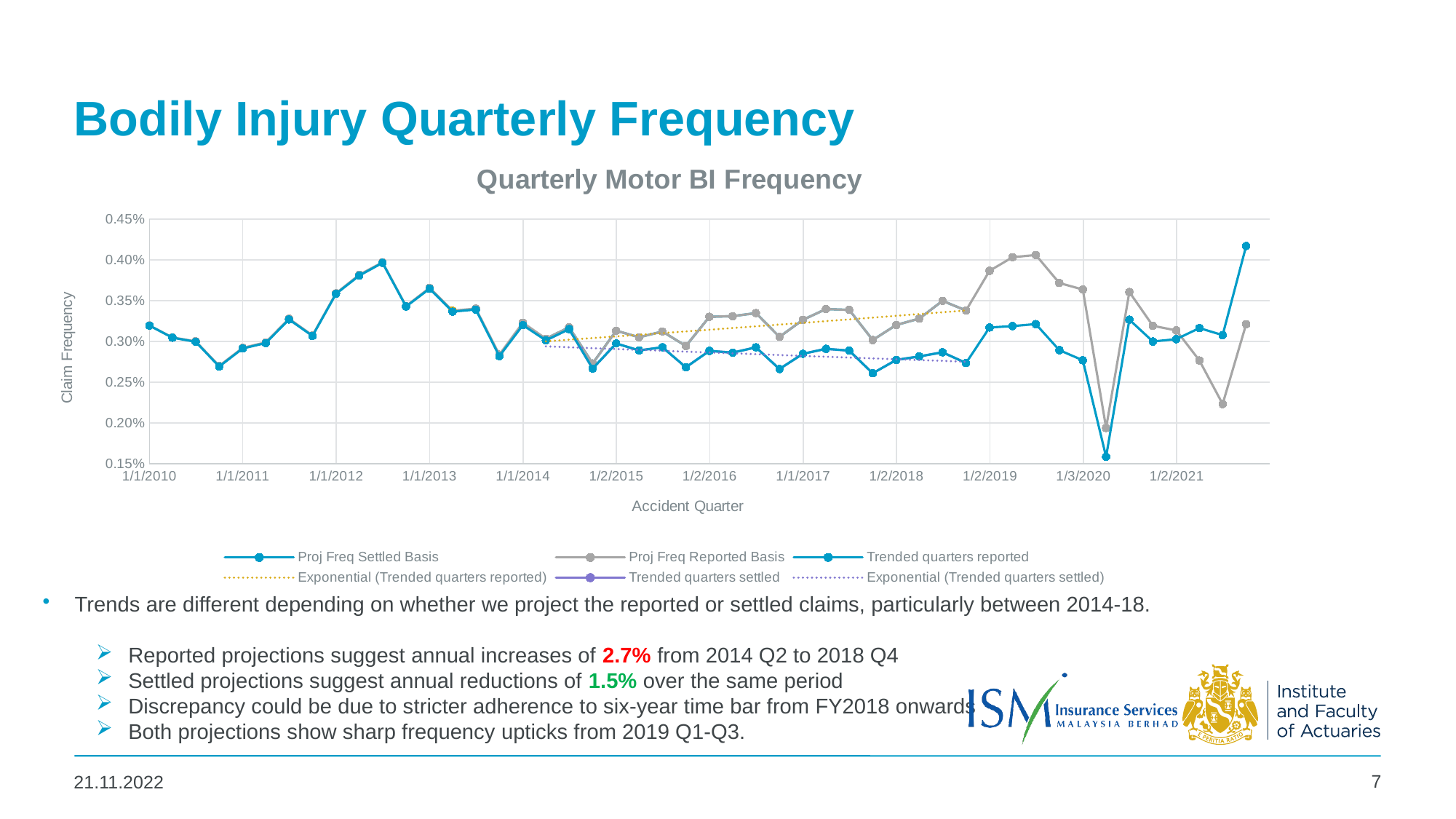
Which series reaches the lowest value anywhere on the chart? Proj Freq Settled Basis Is the value of Proj Freq Settled Basis at 1/1/2010 greater or less than 0.30%? greater Does the Exponential (Trended quarters settled) trend line rise or fall from left to right? Falls Is the lowest point of the Proj Freq Settled Basis series greater or less than 0.20%? less What is the title of the chart? Quarterly Motor BI Frequency At the final (rightmost) point, which is higher: Proj Freq Settled Basis or Proj Freq Reported Basis? Proj Freq Settled Basis Does the Exponential (Trended quarters reported) trend line rise or fall from left to right? Rises Is the highest point of the Proj Freq Reported Basis series greater or less than 0.40%? greater What kind of chart is shown on the slide? Line chart How many series does the legend of the chart list? 6 What is the label of the vertical axis of the chart? Claim Frequency